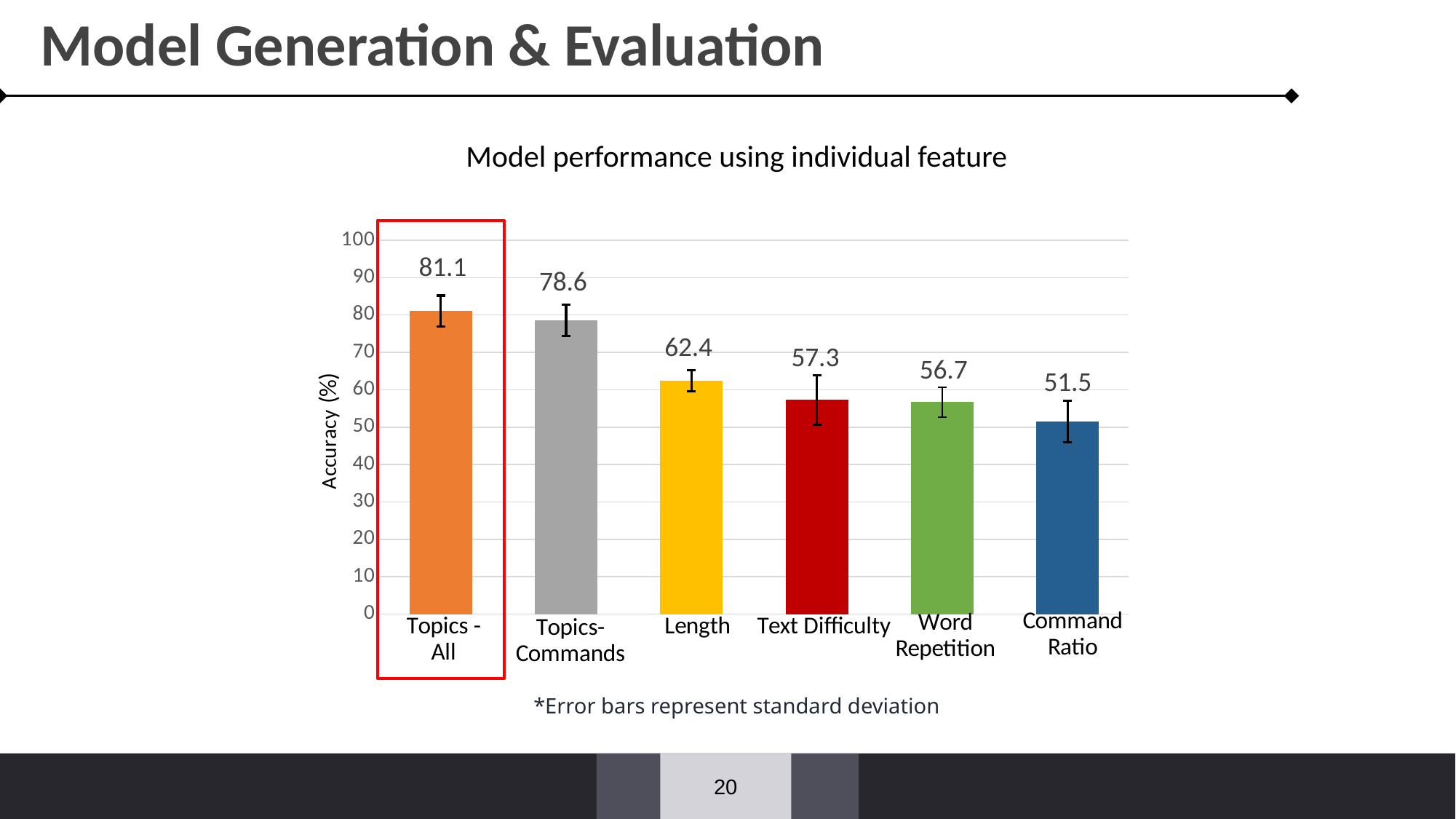
Which has a higher accuracy, Text Difficulty or Word Repetition? Text Difficulty What is the accuracy for Length? 62.4 What is the accuracy for Topics - All? 81.1 Which feature has the highest accuracy? Topics - All What is the difference in accuracy between Length and Text Difficulty? 5.1 What type of chart is shown? Bar chart Which feature has the lowest accuracy? Command Ratio What is the difference in accuracy between Topics - All and Topics-Commands? 2.5 What is the accuracy for Command Ratio? 51.5 What is the accuracy for Word Repetition? 56.7 How many features are shown in the chart? 6 What is the title of the chart? Model performance using individual feature